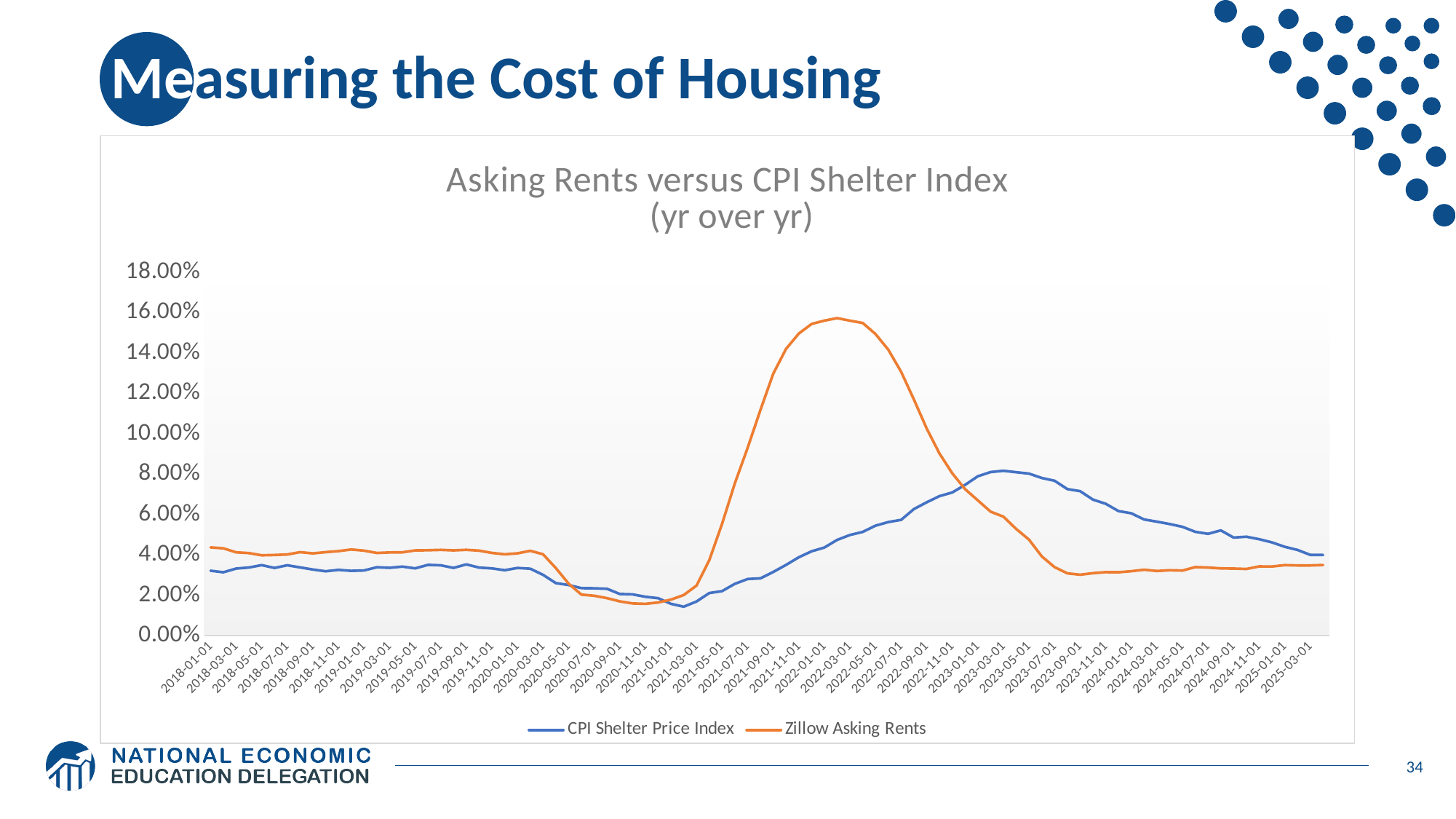
Which series reaches the highest peak on the chart? Zillow Asking Rents How many series does the legend list? 2 Which colour is used for the Zillow Asking Rents line? Orange Does the Zillow Asking Rents line rise or fall between 2022-03-01 and 2023-09-01? Fall At 2022-01-01, which series has the higher value, CPI Shelter Price Index or Zillow Asking Rents? Zillow Asking Rents Is the value for CPI Shelter Price Index at 2023-03-01 greater or less than 6.00%? greater Does the CPI Shelter Price Index line rise or fall between 2021-01-01 and 2023-03-01? Rise Is the value for Zillow Asking Rents at 2020-11-01 greater or less than 4.00%? less Is the value for Zillow Asking Rents at 2022-01-01 greater or less than 14.00%? greater What is the title of the chart? Asking Rents versus CPI Shelter Index (yr over yr) What type of chart is shown on the slide? Line chart At 2023-09-01, which series has the higher value, CPI Shelter Price Index or Zillow Asking Rents? CPI Shelter Price Index